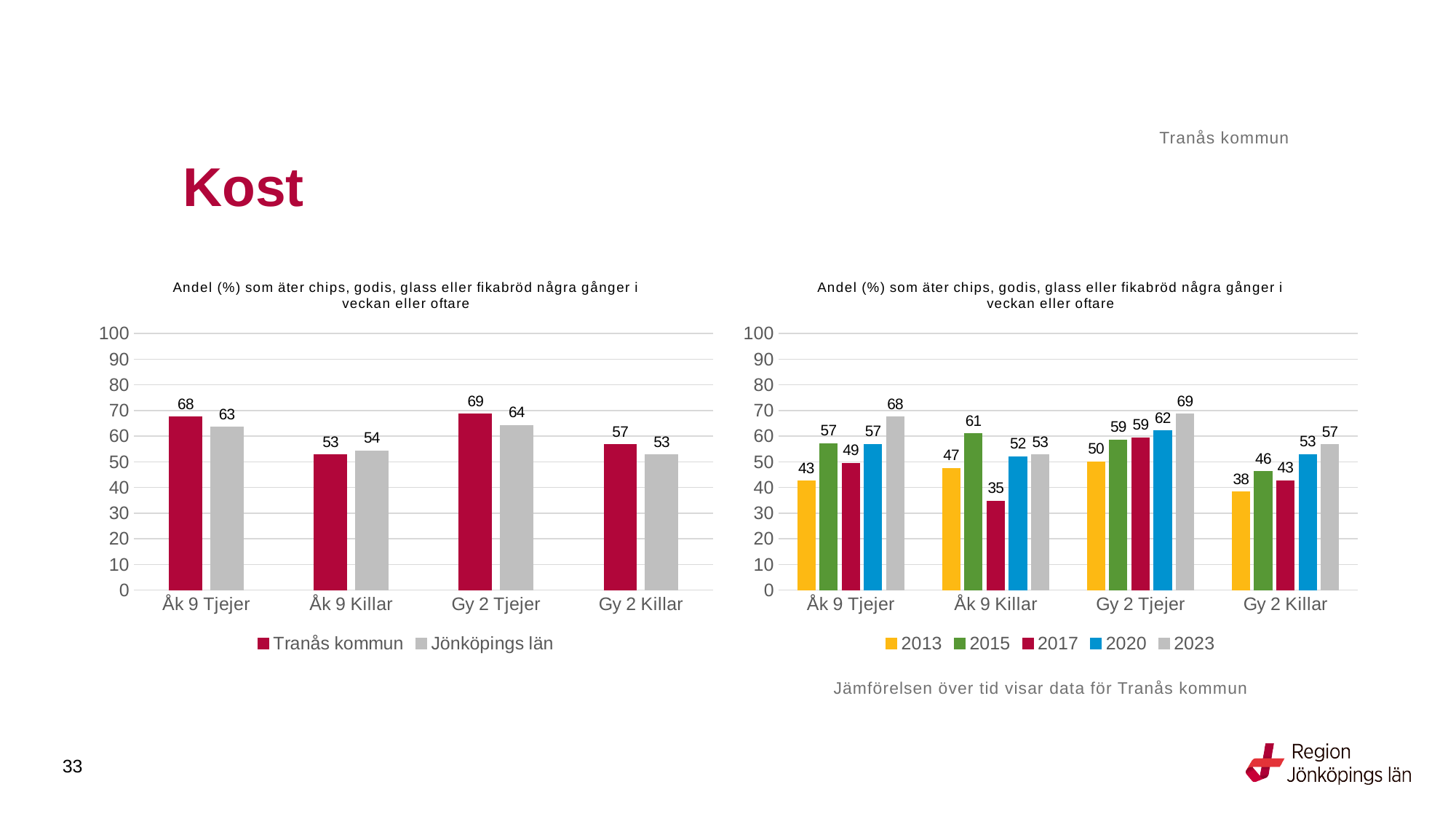
In the left chart, which category has the highest value for Tranås kommun? Gy 2 Tjejer In the right chart, what is the value for 2017 for Åk 9 Killar? 35 In the left chart, what is the value for Jönköpings län for Gy 2 Killar? 53 In the left chart, which is larger for Åk 9 Killar: Tranås kommun or Jönköpings län? Jönköpings län What type of chart is the right chart? Bar chart How many series does the legend of the left chart list? 2 In the left chart, what is the difference between Tranås kommun and Jönköpings län for Åk 9 Tjejer? 5 In the right chart, what is the value for 2023 for Gy 2 Tjejer? 69 How many series does the legend of the right chart list? 5 In the right chart, what is the difference between 2023 and 2013 for Åk 9 Tjejer? 25 In the right chart, which year has the lowest value for Gy 2 Killar? 2013 In the left chart, what is the value for Tranås kommun for Åk 9 Tjejer? 68